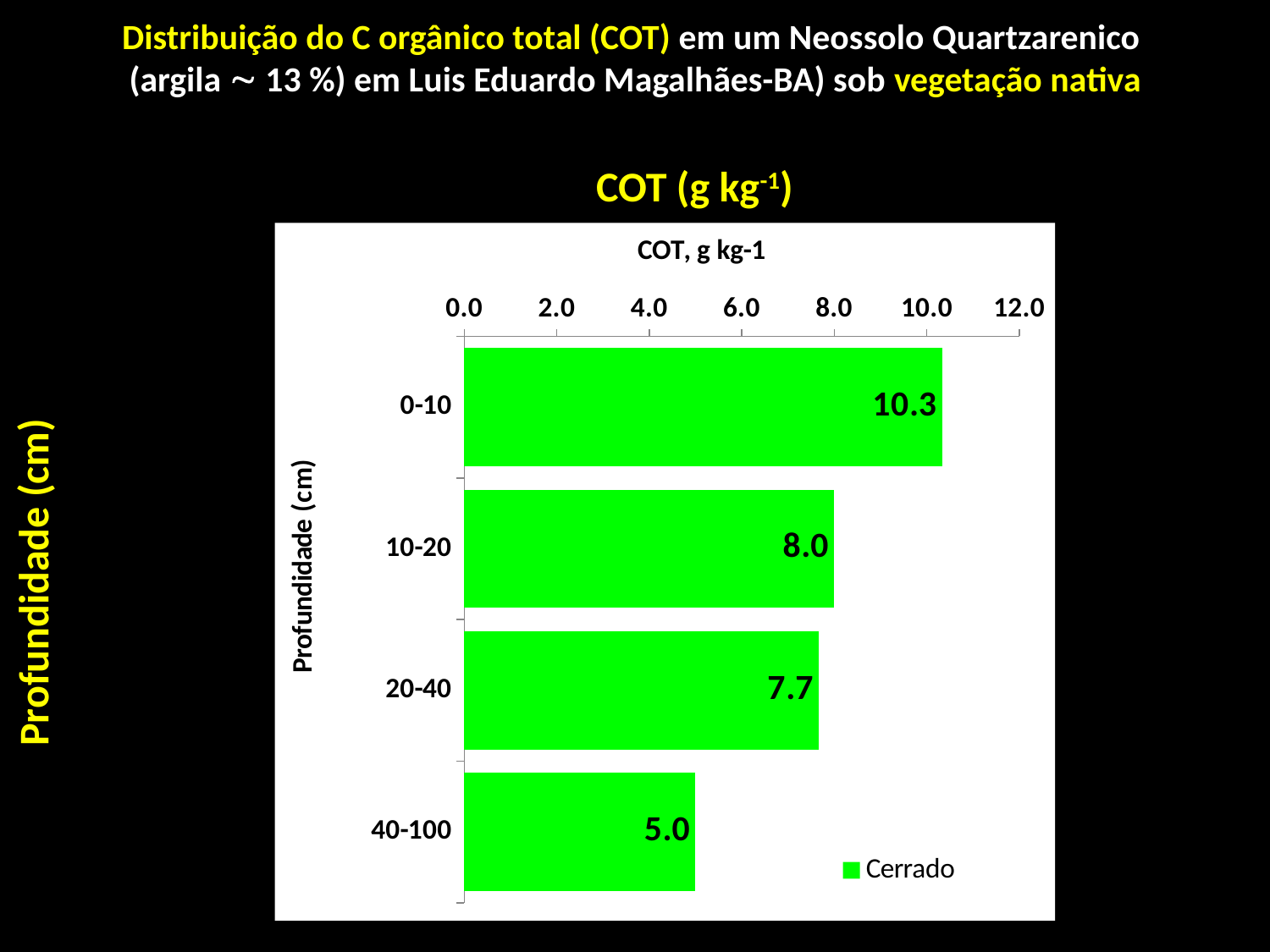
What type of chart is shown on the slide? bar chart Which depth has the highest COT value? 0-10 What is the COT value for the 20-40 cm depth? 7.7 What is the COT value for the 0-10 cm depth? 10.3 What is the difference between the COT values for the 0-10 and 40-100 cm depths? 5.3 Which depth has a larger COT value, 10-20 or 40-100? 10-20 How many depth categories are shown in the chart? 4 Which depth has the lowest COT value? 40-100 What series name is listed in the chart legend? Cerrado Is the COT value for the 20-40 cm depth greater or less than 6.0? greater What is the COT value for the 10-20 cm depth? 8.0 What is the COT value for the 40-100 cm depth? 5.0